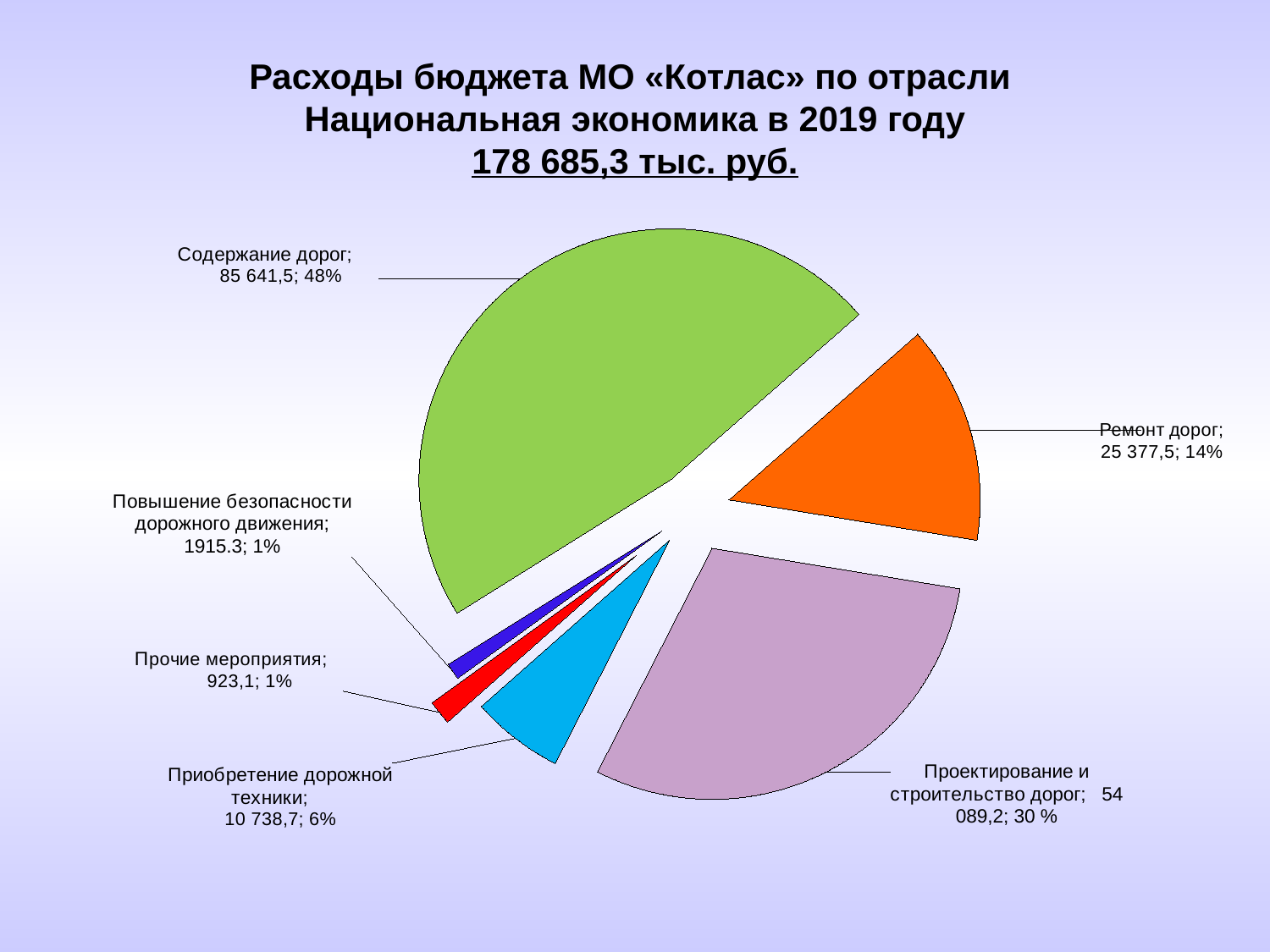
What kind of chart is shown on the slide? pie chart Which category has the largest slice of the pie? Содержание дорог What is the value for Проектирование и строительство дорог? 54 089,2 What is the difference between the values for Содержание дорог and Ремонт дорог? 60 264,0 What share of the pie does Приобретение дорожной техники represent? 6% What total amount is stated in the chart title? 178 685,3 тыс. руб. What is the value for Прочие мероприятия? 923,1 Which is larger, Ремонт дорог or Проектирование и строительство дорог? Проектирование и строительство дорог What is the value for Содержание дорог? 85 641,5 How many slices does the pie chart have? 6 What share of the pie does Ремонт дорог represent? 14%